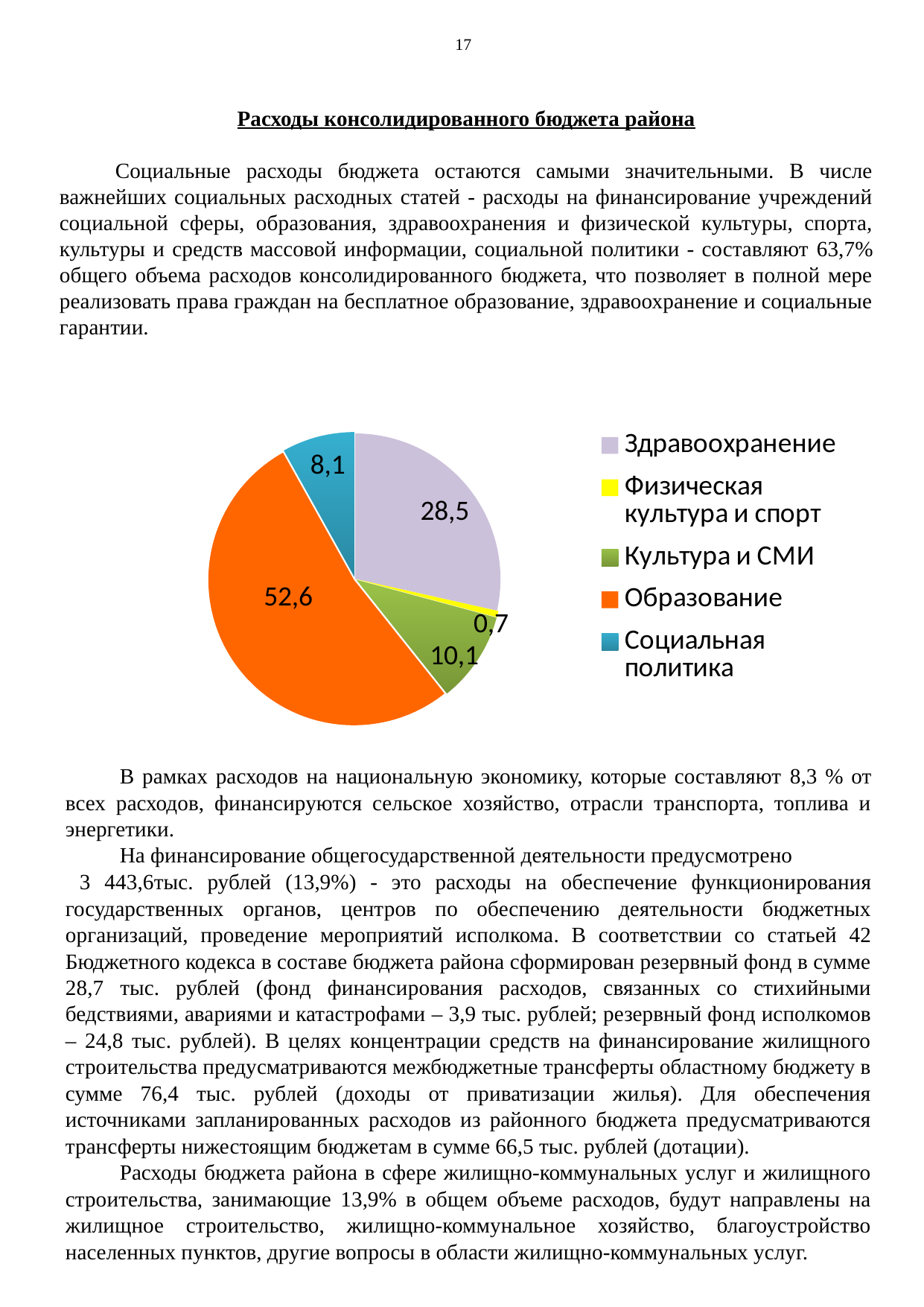
How many categories does the pie chart legend list? 5 What is the difference between the values for Образование and Здравоохранение in the pie chart? 24,1 What is the value shown for Социальная политика in the pie chart? 8,1 What kind of chart is shown on the slide? pie chart What is the value shown for Здравоохранение in the pie chart? 28,5 What colour is the Образование slice in the pie chart? orange Which is larger in the pie chart, Культура и СМИ or Социальная политика? Культура и СМИ What is the value shown for Образование in the pie chart? 52,6 Which category has the smallest slice in the pie chart? Физическая культура и спорт What is the value shown for Культура и СМИ in the pie chart? 10,1 Which category has the largest slice in the pie chart? Образование What is the value shown for Физическая культура и спорт in the pie chart? 0,7